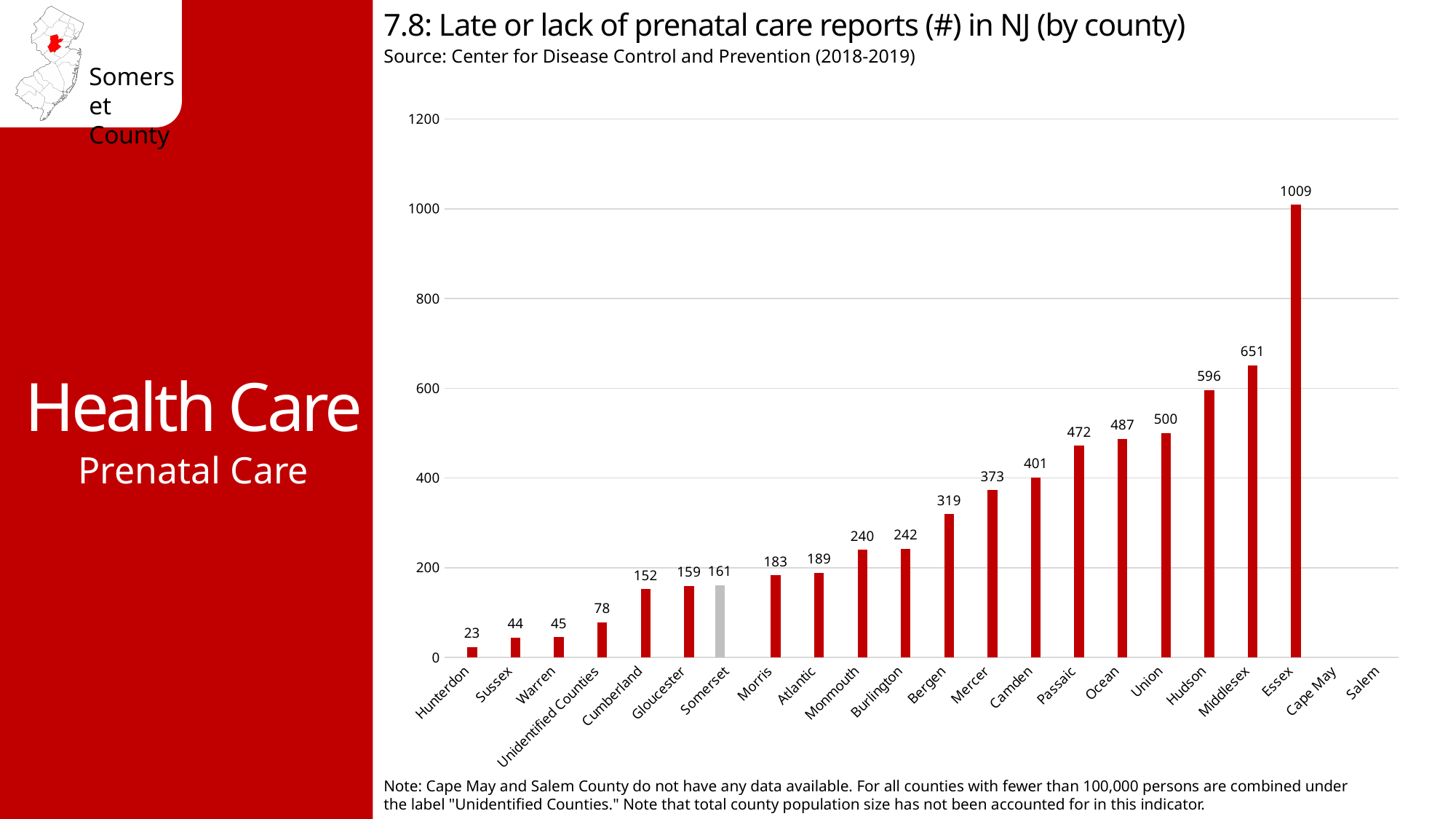
Do the values generally rise or fall from Hunterdon to Essex along the x axis? Rise What is the value shown for Hunterdon? 23 How many categories are labelled on the x axis? 22 What kind of chart is shown on the slide? Bar chart Is the value for Union greater or less than 400? greater What is the value shown for Essex? 1009 Which county has the highest number of late or lack of prenatal care reports? Essex What is the difference between the values for Middlesex and Hudson? 55 Which has a higher value, Bergen or Mercer? Mercer Which bar is coloured grey instead of red? Somerset Which county with a plotted bar has the lowest value? Hunterdon What is the number of late or lack of prenatal care reports for Somerset? 161